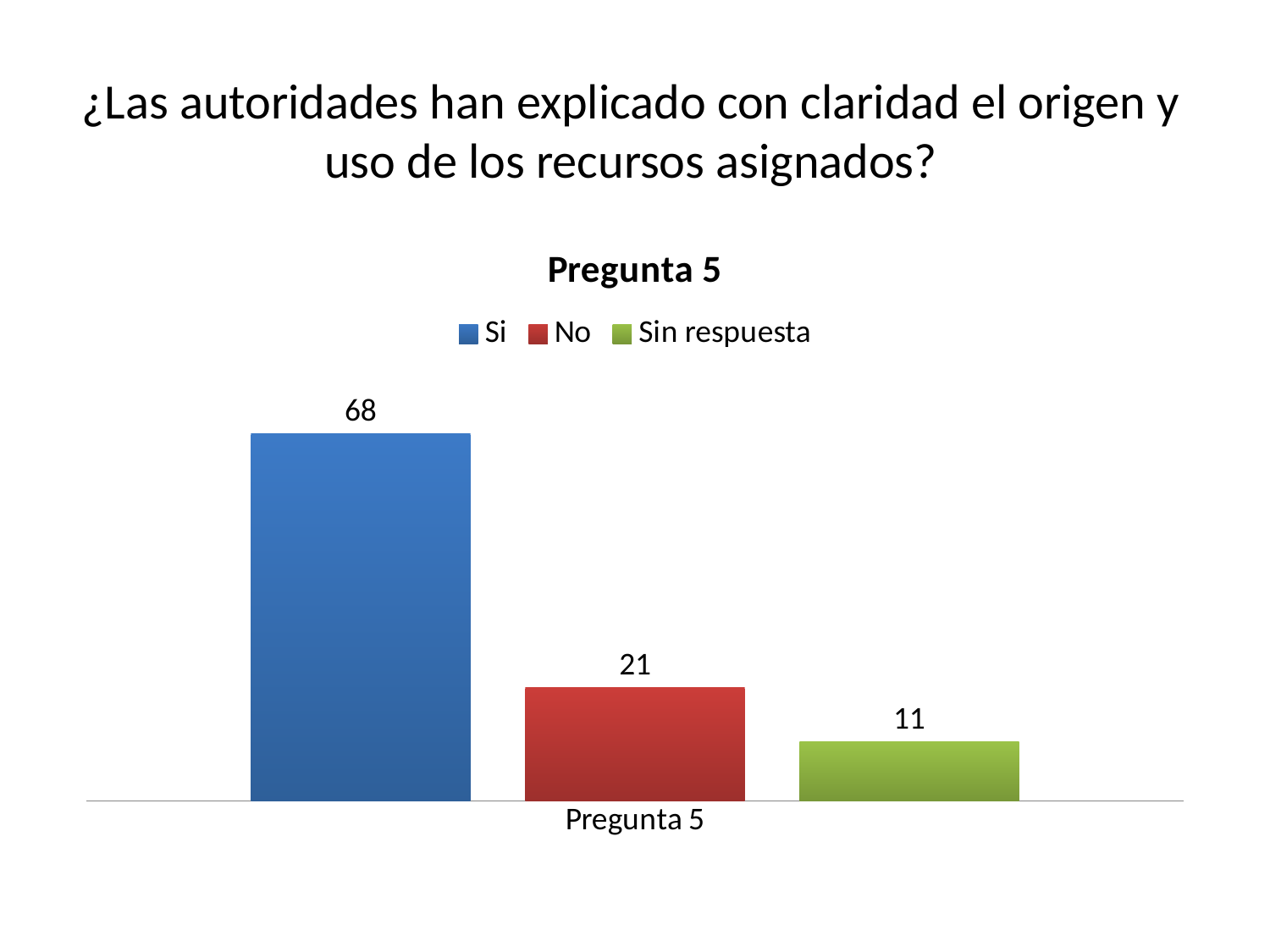
What kind of chart is shown? Bar chart What is the total of the three values shown? 100 Which series has the lowest value? Sin respuesta What is the value for No? 21 What is the value for Sin respuesta? 11 What is the title of the chart? Pregunta 5 How many series does the legend list? 3 What is the difference between the values for Si and No? 47 What is the difference between the values for No and Sin respuesta? 10 What is the value for Si? 68 Which is larger, the value for No or the value for Sin respuesta? No Which series has the highest value? Si